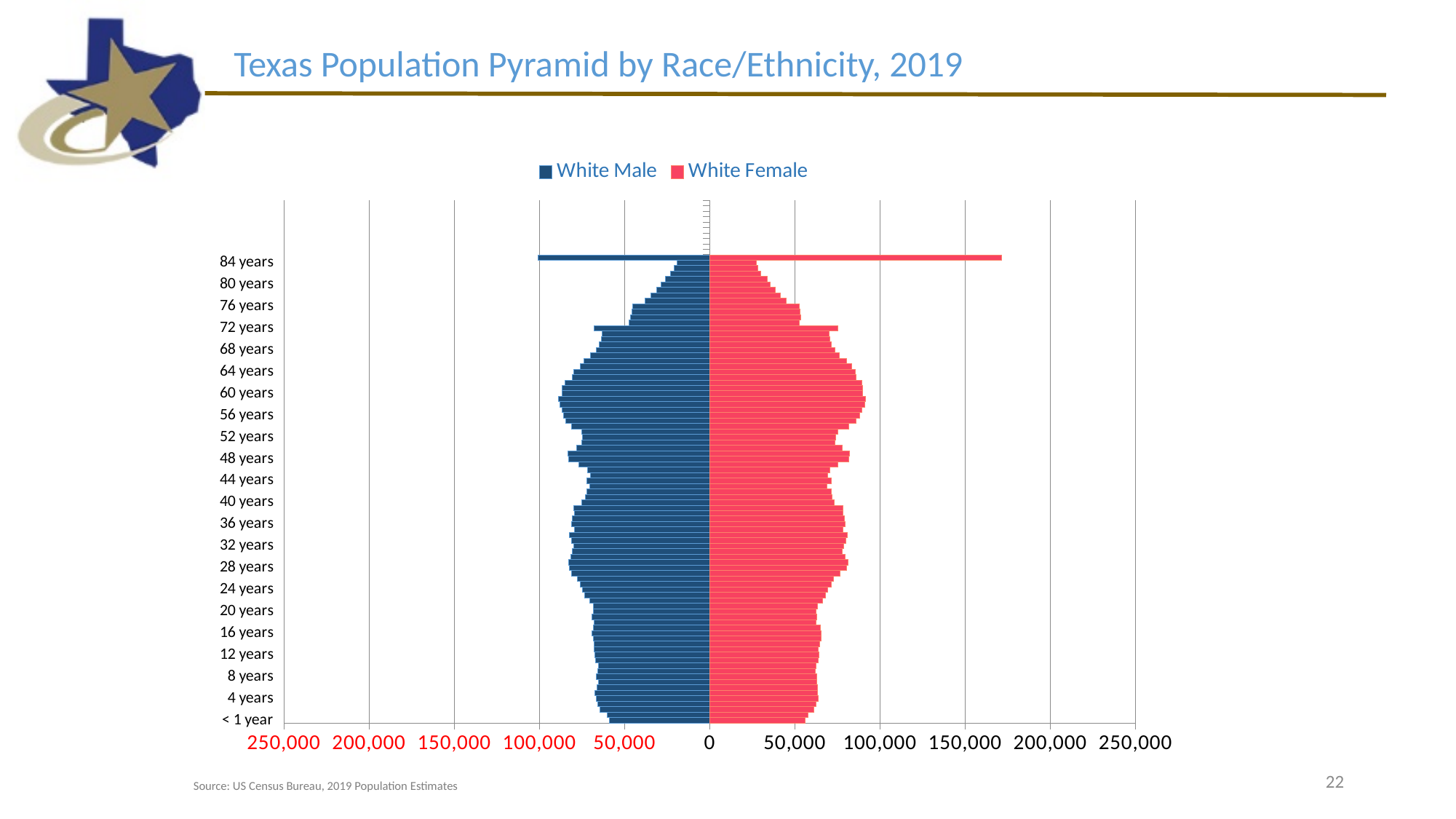
Is the White Male value for 60 years greater or less than 50,000? greater How many series does the legend list? 2 What is the title of the slide's chart? Texas Population Pyramid by Race/Ethnicity, 2019 At 84 years, which is larger: the White Male value or the White Female value? White Female Moving from 80 years down to 60 years, do the White Female values rise or fall? rise What kind of chart is shown on the slide? bar chart Which colour represents the White Female series? Red/pink Is the White Female value for 60 years greater or less than 100,000? less Is the White Female value for 80 years greater or less than 50,000? less